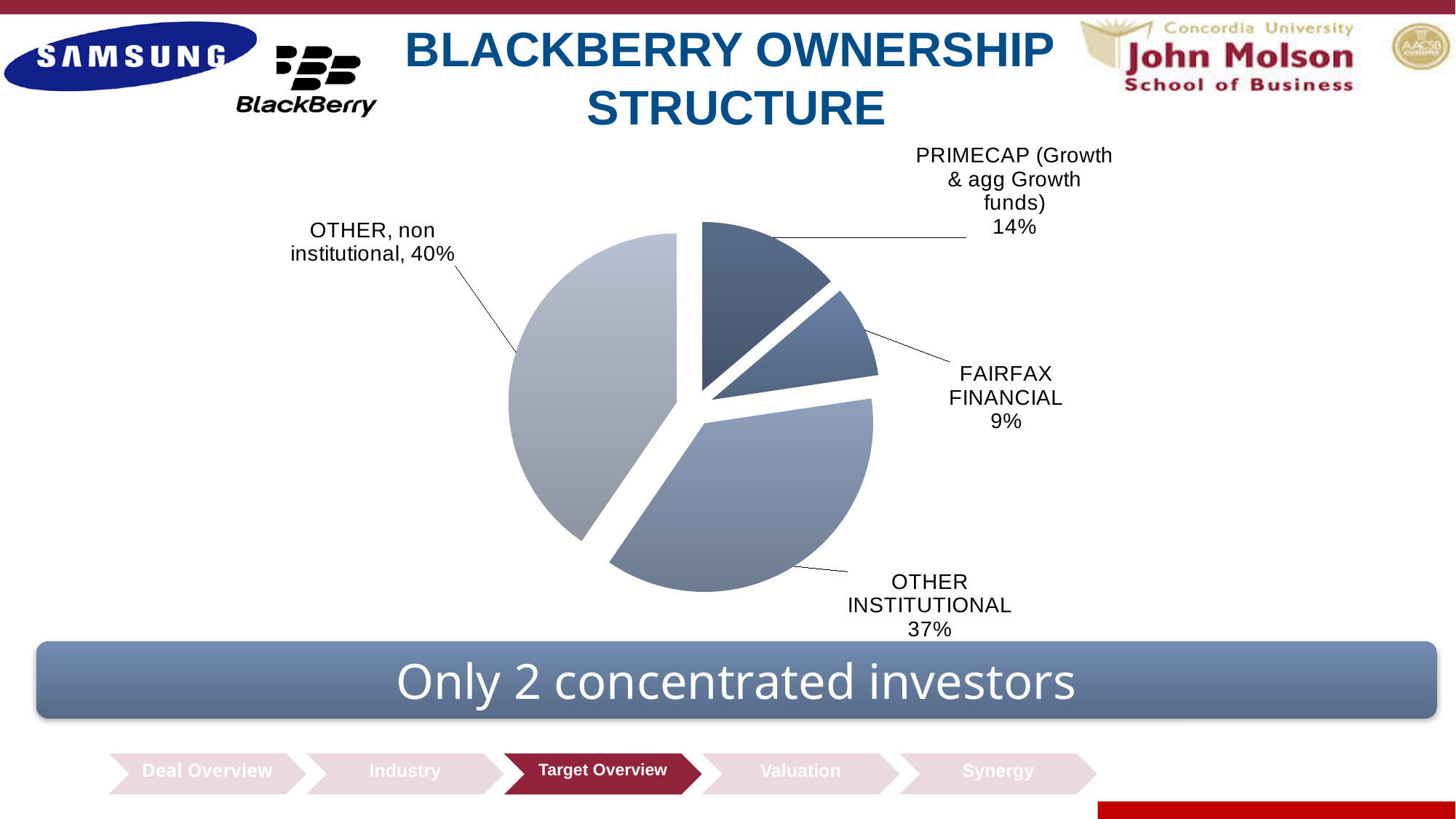
What share of BlackBerry ownership is held by PRIMECAP (Growth & agg Growth funds)? 14% What kind of chart is shown on the slide? Pie chart What is the combined share of PRIMECAP and FAIRFAX FINANCIAL? 23% What share of BlackBerry ownership is held by OTHER INSTITUTIONAL? 37% How many slices does the pie chart have? 4 Which slice of the pie chart is the smallest? FAIRFAX FINANCIAL Which slice of the pie chart is the largest? OTHER, non institutional Which is larger, the PRIMECAP share or the FAIRFAX FINANCIAL share? PRIMECAP (Growth & agg Growth funds) What is the title of the chart on the slide? BLACKBERRY OWNERSHIP STRUCTURE What share of BlackBerry ownership is held by OTHER, non institutional? 40% What share of BlackBerry ownership is held by FAIRFAX FINANCIAL? 9% What is the difference in percentage points between OTHER, non institutional and OTHER INSTITUTIONAL? 3